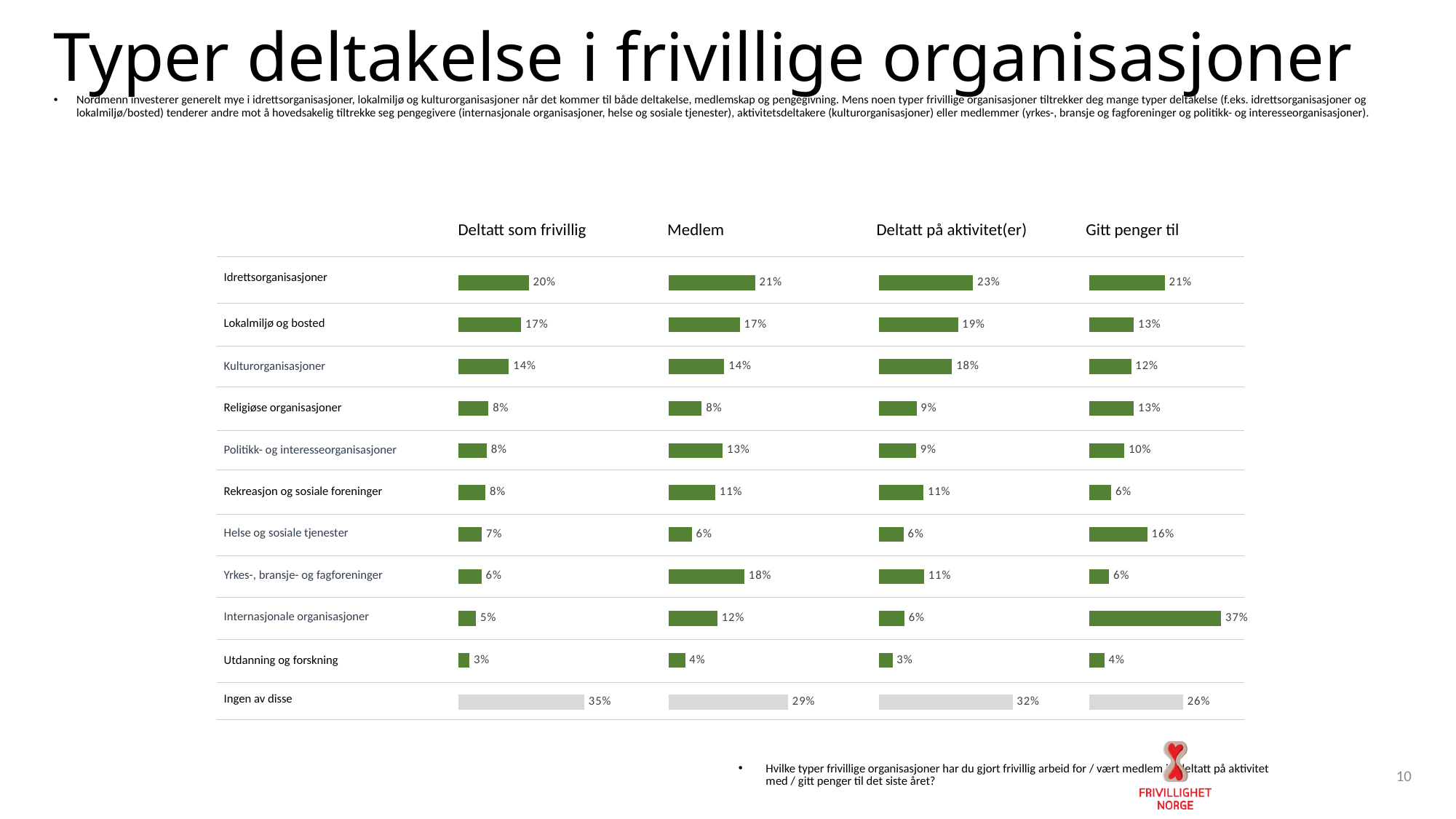
In the "Medlem" chart, what is the value for Yrkes-, bransje- og fagforeninger? 18% What kind of chart is used on this slide? Bar chart How many chart columns (participation types) are shown on the slide? 4 In the "Gitt penger til" chart, which category has the highest value? Internasjonale organisasjoner In the "Deltatt som frivillig" chart, what is the value for Idrettsorganisasjoner? 20% In the "Deltatt på aktivitet(er)" chart, which organisation type has the highest value among the green bars? Idrettsorganisasjoner In the "Deltatt som frivillig" chart, which category has the lowest value? Utdanning og forskning In the "Gitt penger til" chart, what is the difference between Internasjonale organisasjoner and Helse og sosiale tjenester? 21% In the "Deltatt på aktivitet(er)" chart, which is larger: Kulturorganisasjoner or Lokalmiljø og bosted? Lokalmiljø og bosted How many organisation categories (rows) are shown in each chart? 11 In the "Medlem" chart, what is the difference between Idrettsorganisasjoner and Utdanning og forskning? 17% In the "Gitt penger til" chart, what is the value for Internasjonale organisasjoner? 37%